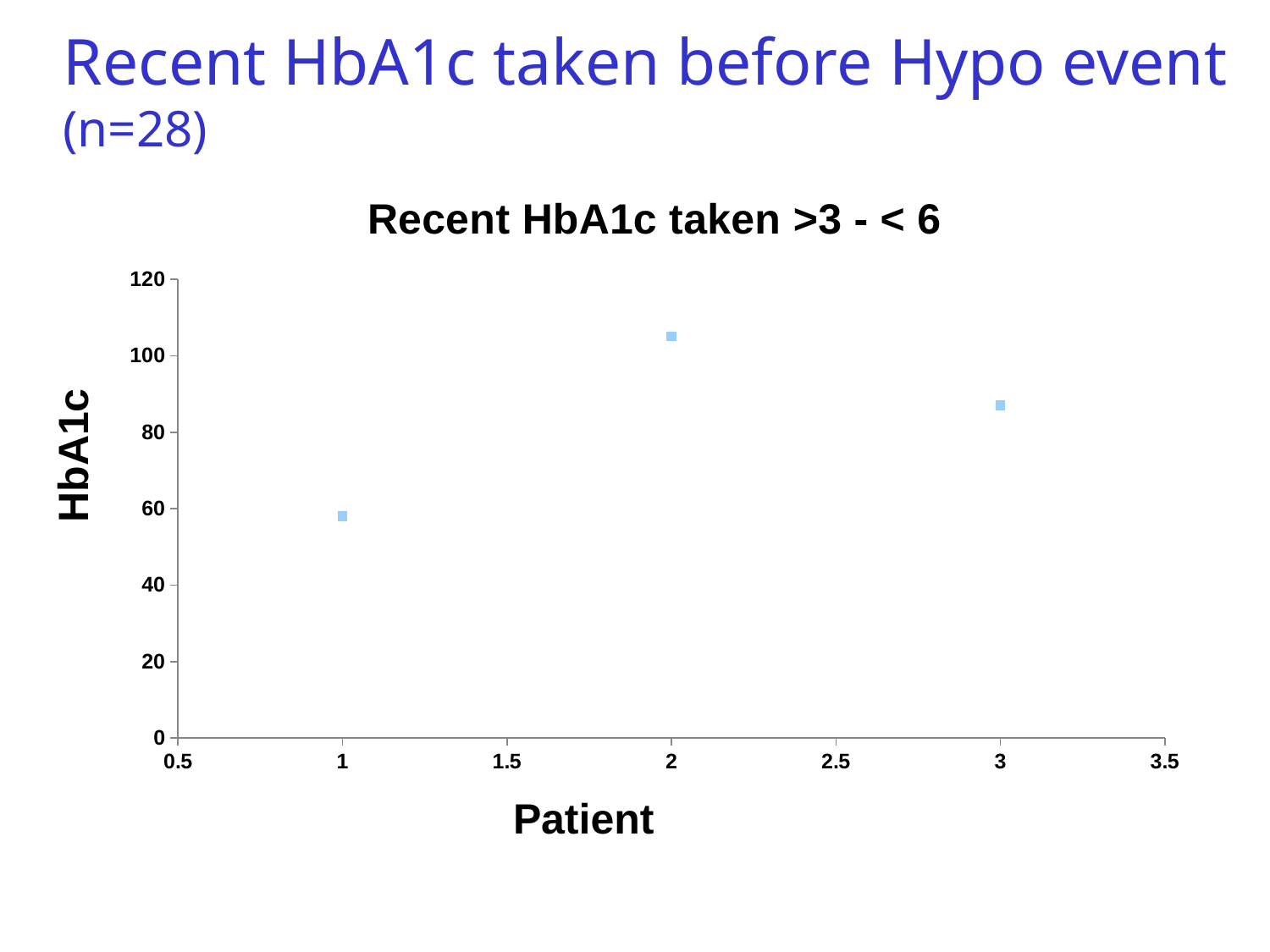
What is the label of the vertical axis? HbA1c Which patient has the lowest HbA1c value? 1 What is the title of the chart? Recent HbA1c taken >3 - < 6 Which has a higher HbA1c value, patient 2 or patient 3? patient 2 Is the HbA1c value for patient 2 greater or less than 100? greater Is the HbA1c value for patient 3 greater or less than 80? greater How many data points are plotted on the chart? 3 Which has a higher HbA1c value, patient 1 or patient 3? patient 3 Which patient has the highest HbA1c value? 2 What kind of chart is shown on the slide? scatter chart Is the HbA1c value for patient 1 greater or less than 40? greater